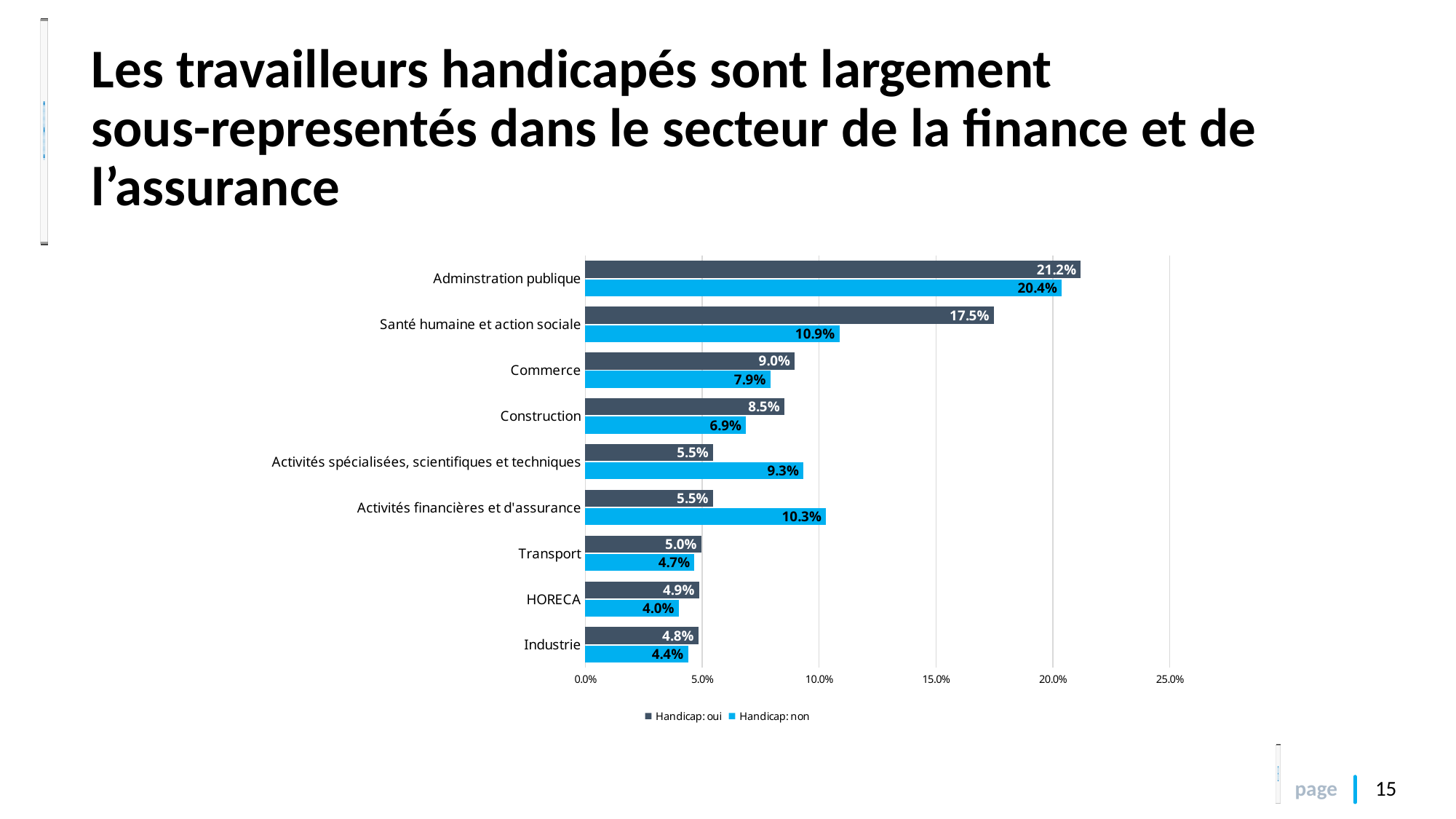
How many categories are shown on the chart? 9 Which category has the lowest value for 'Handicap: non'? HORECA What is the difference between 'Handicap: oui' and 'Handicap: non' for Santé humaine et action sociale? 6.6% Which category has the highest value for 'Handicap: oui'? Adminstration publique What is the value for 'Handicap: non' in HORECA? 4.0% For Activités spécialisées, scientifiques et techniques, which series has the larger value: 'Handicap: oui' or 'Handicap: non'? Handicap: non How many series does the legend list? 2 What is the value for 'Handicap: non' in Santé humaine et action sociale? 10.9% What is the value for 'Handicap: oui' in Activités financières et d'assurance? 5.5% Is the 'Handicap: oui' value for Santé humaine et action sociale greater or less than 15.0%? greater What is the difference between 'Handicap: non' and 'Handicap: oui' for Activités financières et d'assurance? 4.8% What kind of chart is shown on the slide? Bar chart